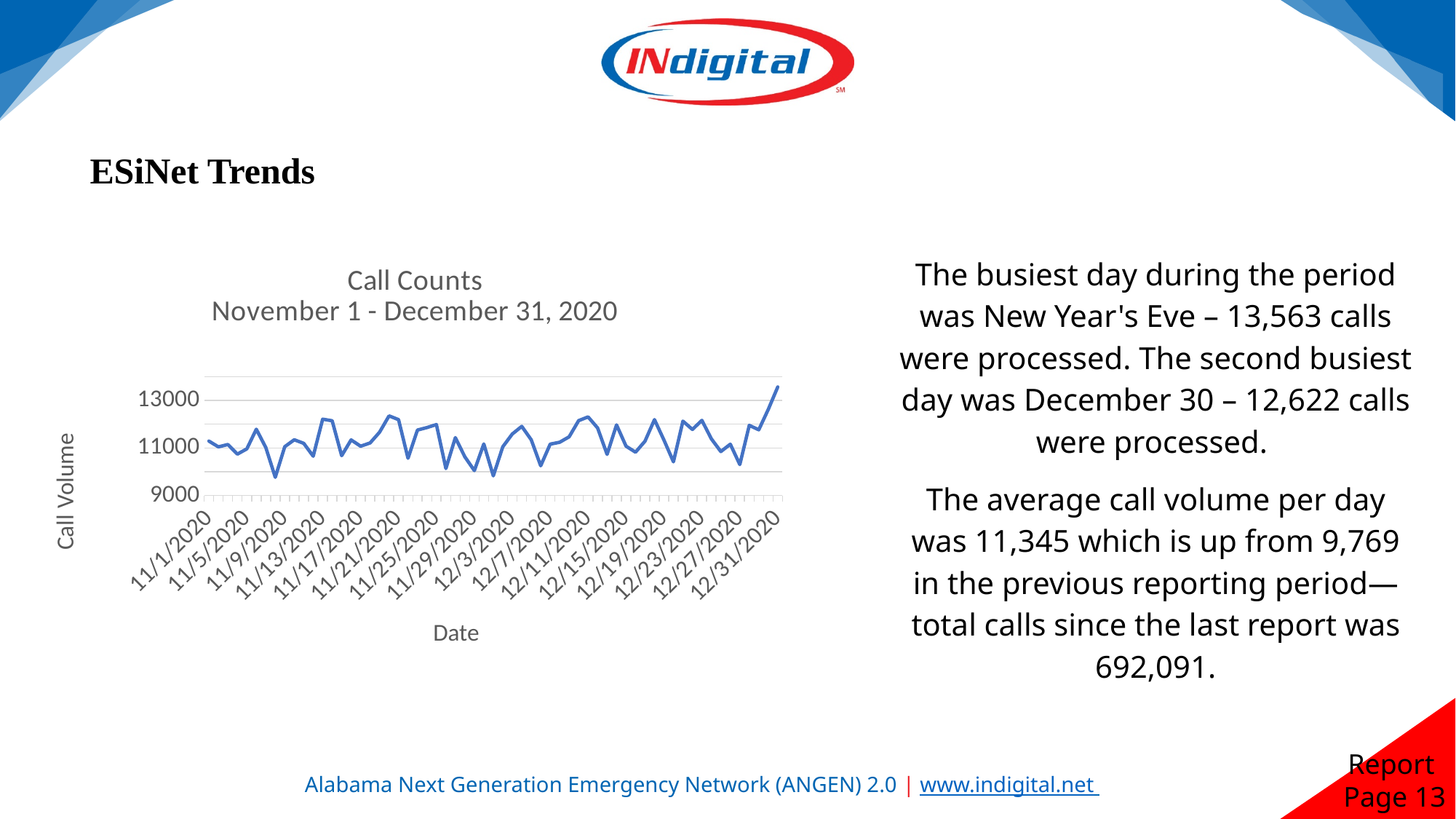
Does the line end higher or lower at 12/31/2020 than it starts at 11/1/2020? higher How many data series are plotted on the chart? 1 On which date does the chart reach its highest call volume? 12/31/2020 What is the title of the chart? Call Counts November 1 - December 31, 2020 Is the value for 12/31/2020 greater or less than 13000? greater What kind of chart is shown on the slide? line chart Which date has the larger call volume, 12/31/2020 or 11/9/2020? 12/31/2020 Is the value for 12/31/2020 greater or less than 11000? greater What is the label on the vertical axis of the chart? Call Volume